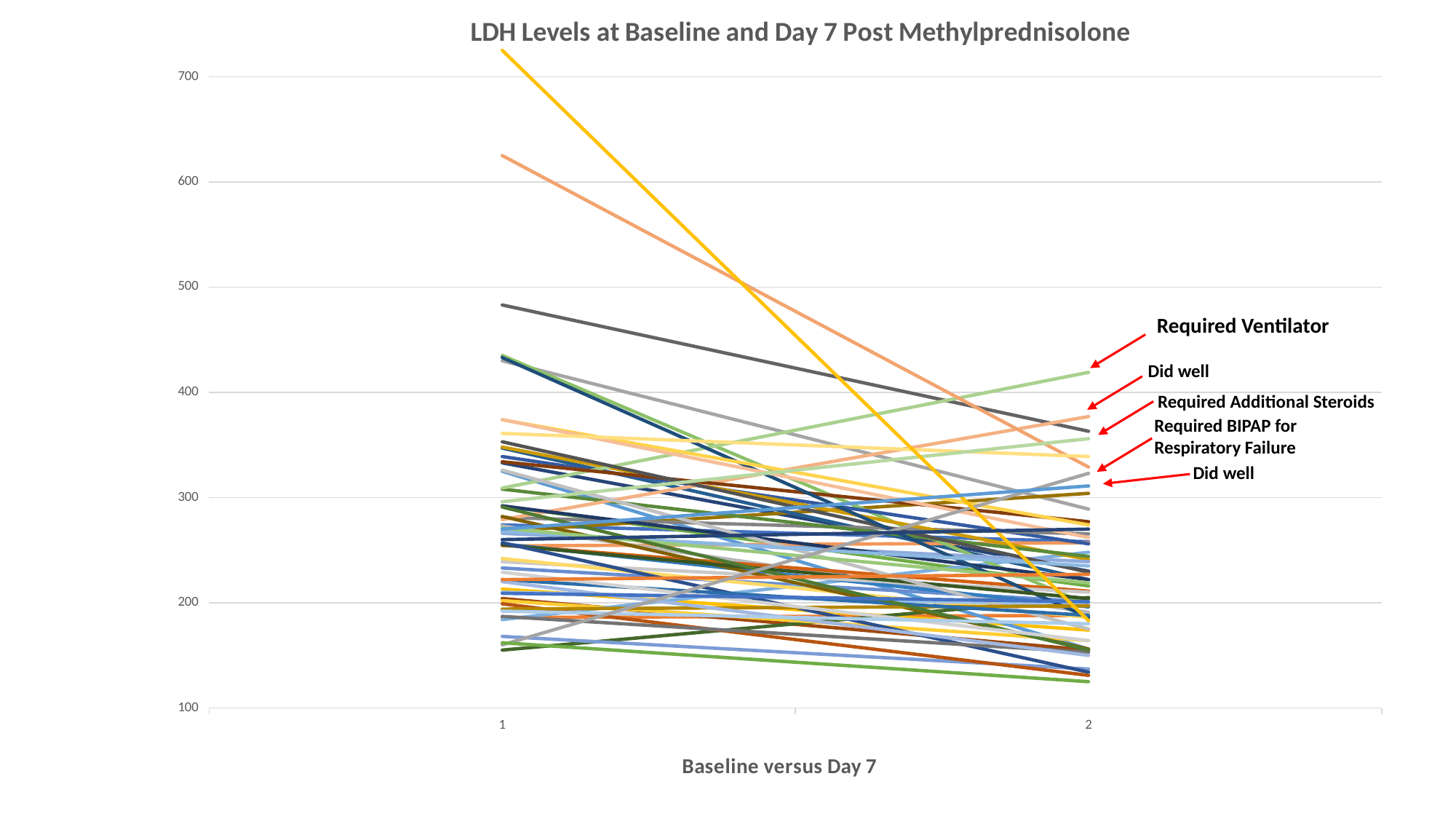
Is the value at x = 2 of the line annotated 'Required Ventilator' greater or less than 400? greater Is the lowest value plotted at x = 2 greater or less than 200? less What is the title of the chart? LDH Levels at Baseline and Day 7 Post Methylprednisolone Does the line that starts highest at x = 1 rise or fall from x = 1 to x = 2? fall What is the highest tick value shown on the y axis? 700 What kind of chart is shown on the slide? line chart How many points are there along the x axis of the chart? 2 Does the line annotated 'Required Ventilator' rise or fall from x = 1 to x = 2? rise Which x-axis point has the higher maximum plotted value, 1 or 2? 1 What is the label on the x axis of the chart? Baseline versus Day 7 Is the highest value plotted at x = 1 greater or less than 700? greater